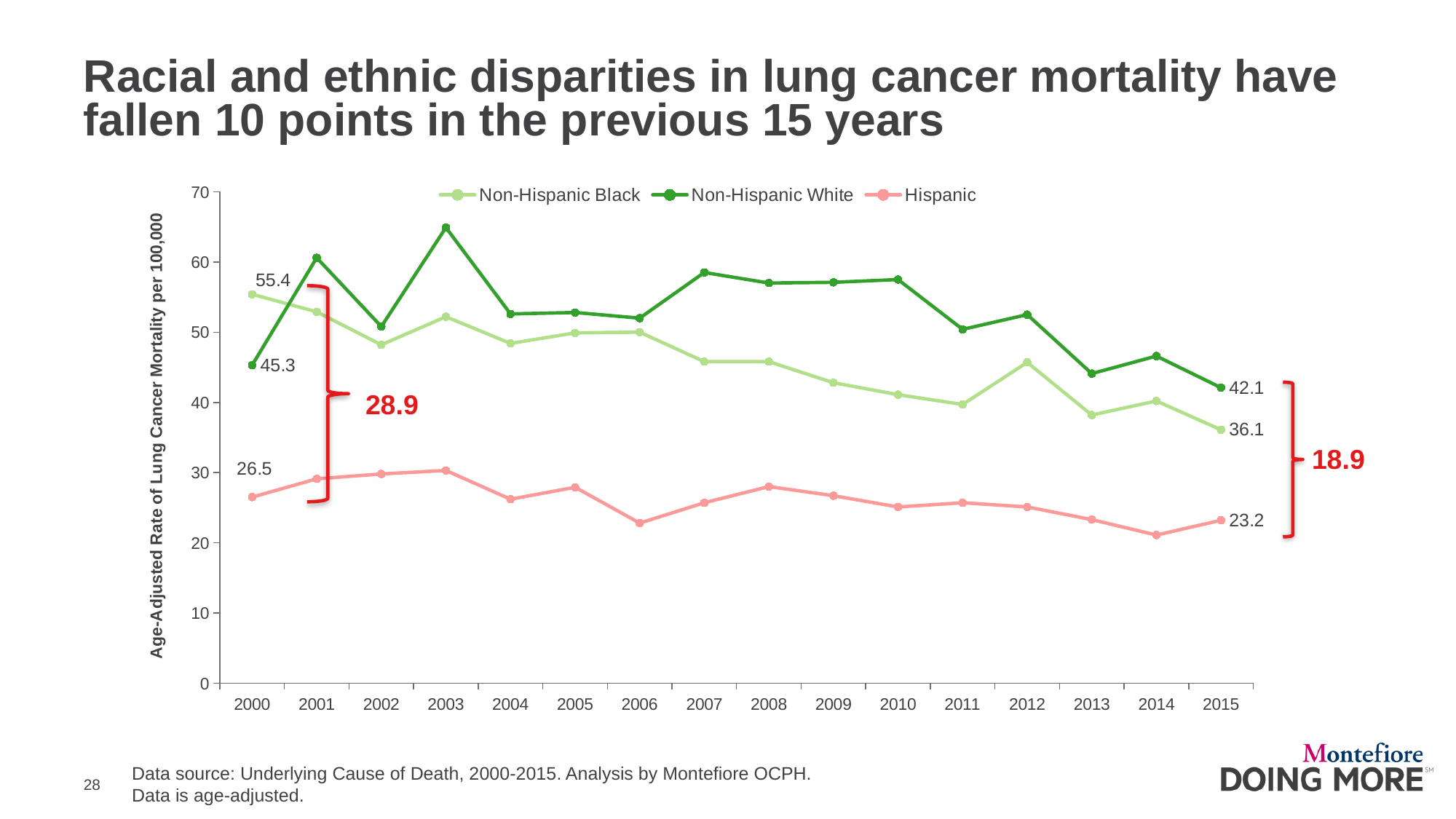
What was the lung cancer mortality rate for Hispanic in 2015? 23.2 How many series does the legend list? 3 What was the lung cancer mortality rate for Non-Hispanic White in 2015? 42.1 What was the lung cancer mortality rate for Non-Hispanic Black in 2000? 55.4 What type of chart is shown on the slide? line chart Is the Non-Hispanic White value for 2003 greater or less than 60? greater How many years are plotted along the x axis? 16 Which series had the lowest rate in 2000? Hispanic What is the difference between the Non-Hispanic White rate and the Hispanic rate in 2015? 18.9 What was the lung cancer mortality rate for Hispanic in 2000? 26.5 What is the difference between the Non-Hispanic Black rate and the Hispanic rate in 2000? 28.9 Which series had the highest rate in 2015? Non-Hispanic White